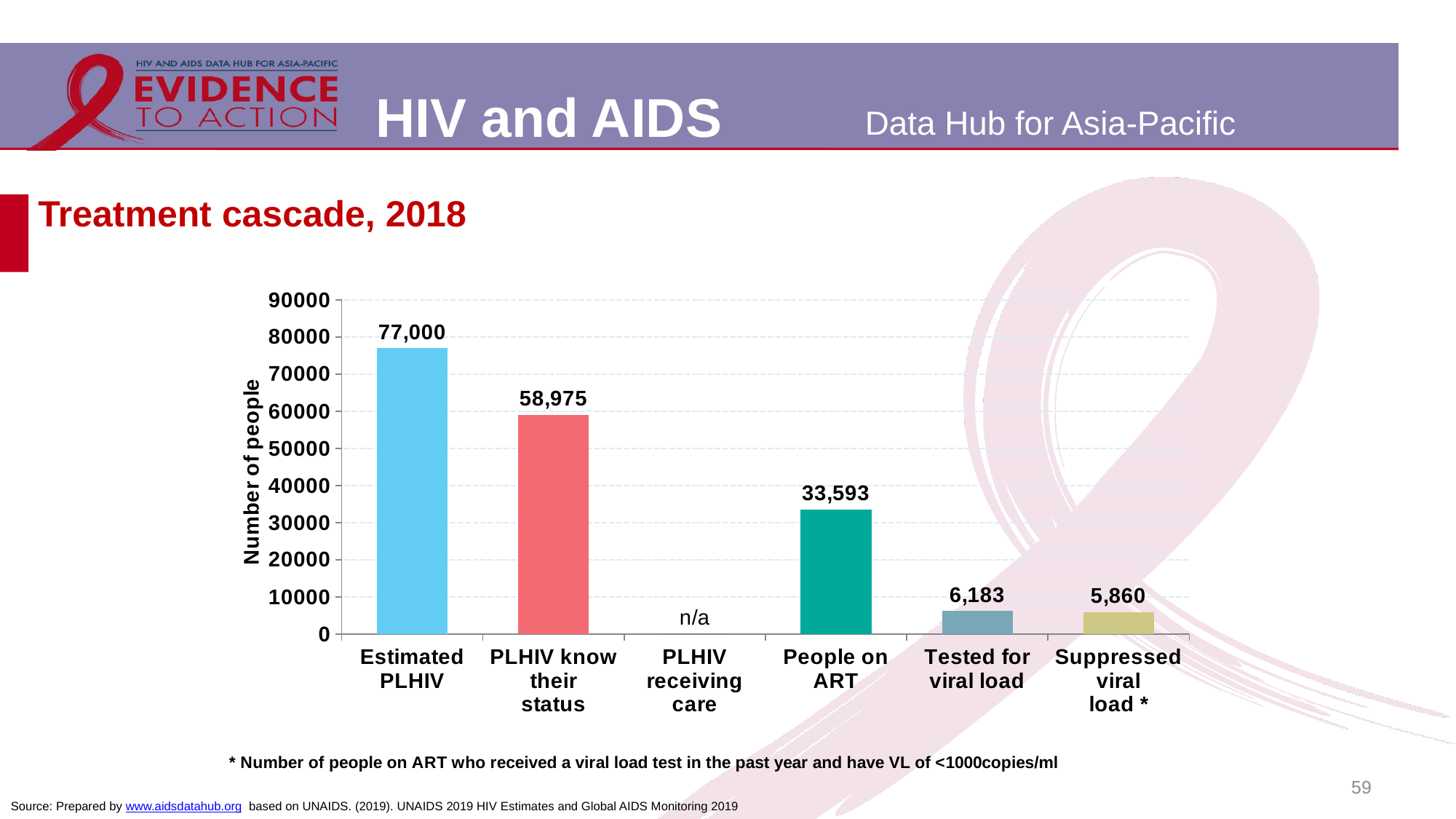
What is the value for PLHIV know their status? 58,975 What is the value for Tested for viral load? 6,183 What is the difference between Estimated PLHIV and PLHIV know their status? 18,025 Which category has the highest value? Estimated PLHIV How many categories are shown on the x axis? 6 What is the y-axis label of the chart? Number of people What is shown for PLHIV receiving care? n/a What is the value for People on ART? 33,593 What is the value for Estimated PLHIV? 77,000 What kind of chart is this? Bar chart Which is larger, People on ART or Tested for viral load? People on ART Which category with a plotted bar has the lowest value? Suppressed viral load *